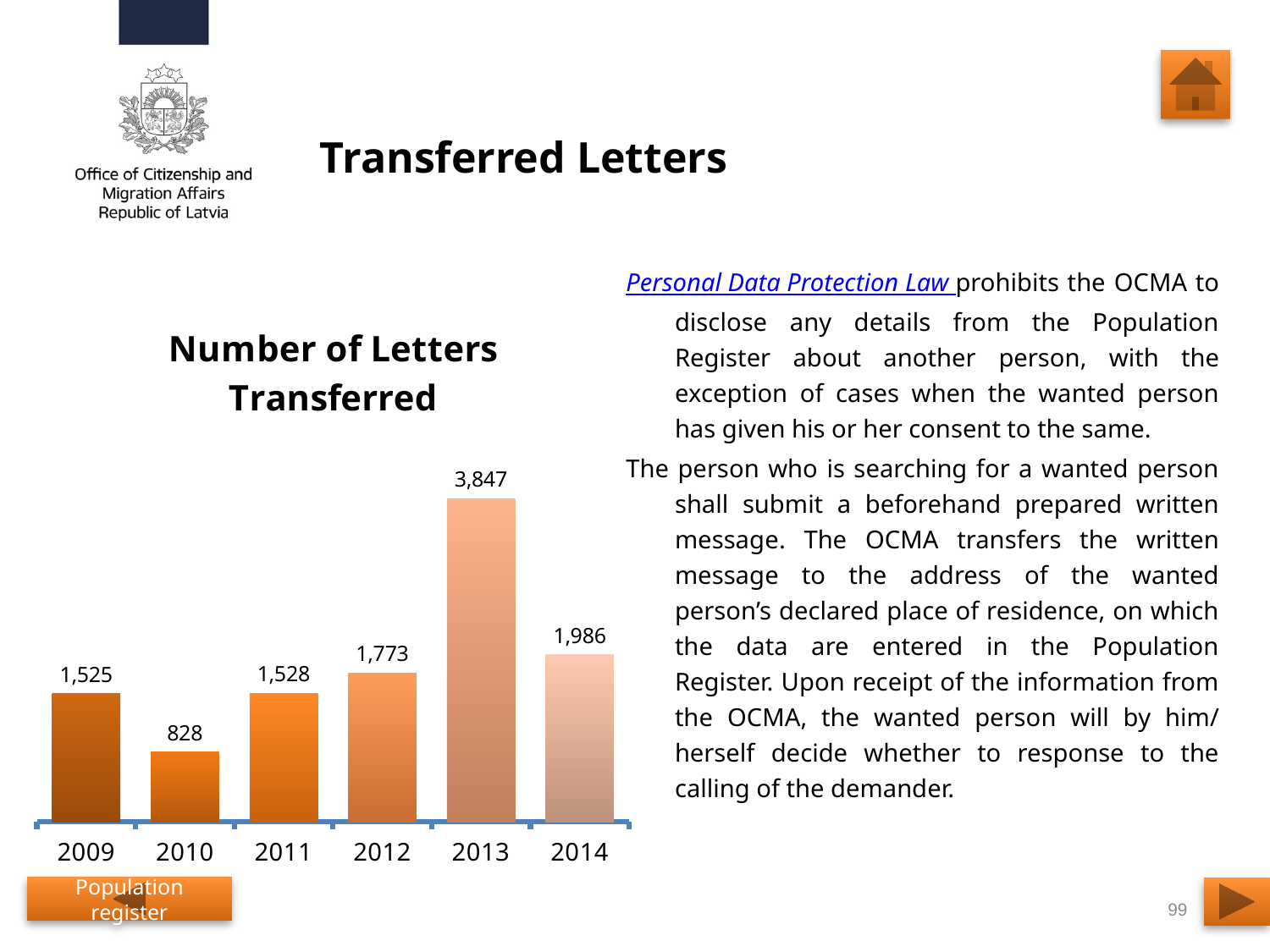
What is the difference between the number of letters transferred in 2009 and 2010? 697 What is the number of letters transferred in 2010? 828 What is the title of the chart? Number of Letters Transferred Which year has the lowest number of letters transferred? 2010 Which year had more letters transferred, 2012 or 2014? 2014 Which year has the highest number of letters transferred? 2013 Did the number of letters transferred rise or fall from 2010 to 2013? Rise What is the number of letters transferred in 2014? 1,986 How many years are shown on the chart? 6 What is the number of letters transferred in 2013? 3,847 What is the difference between the number of letters transferred in 2013 and 2014? 1,861 What type of chart is used to show the number of letters transferred? Bar chart